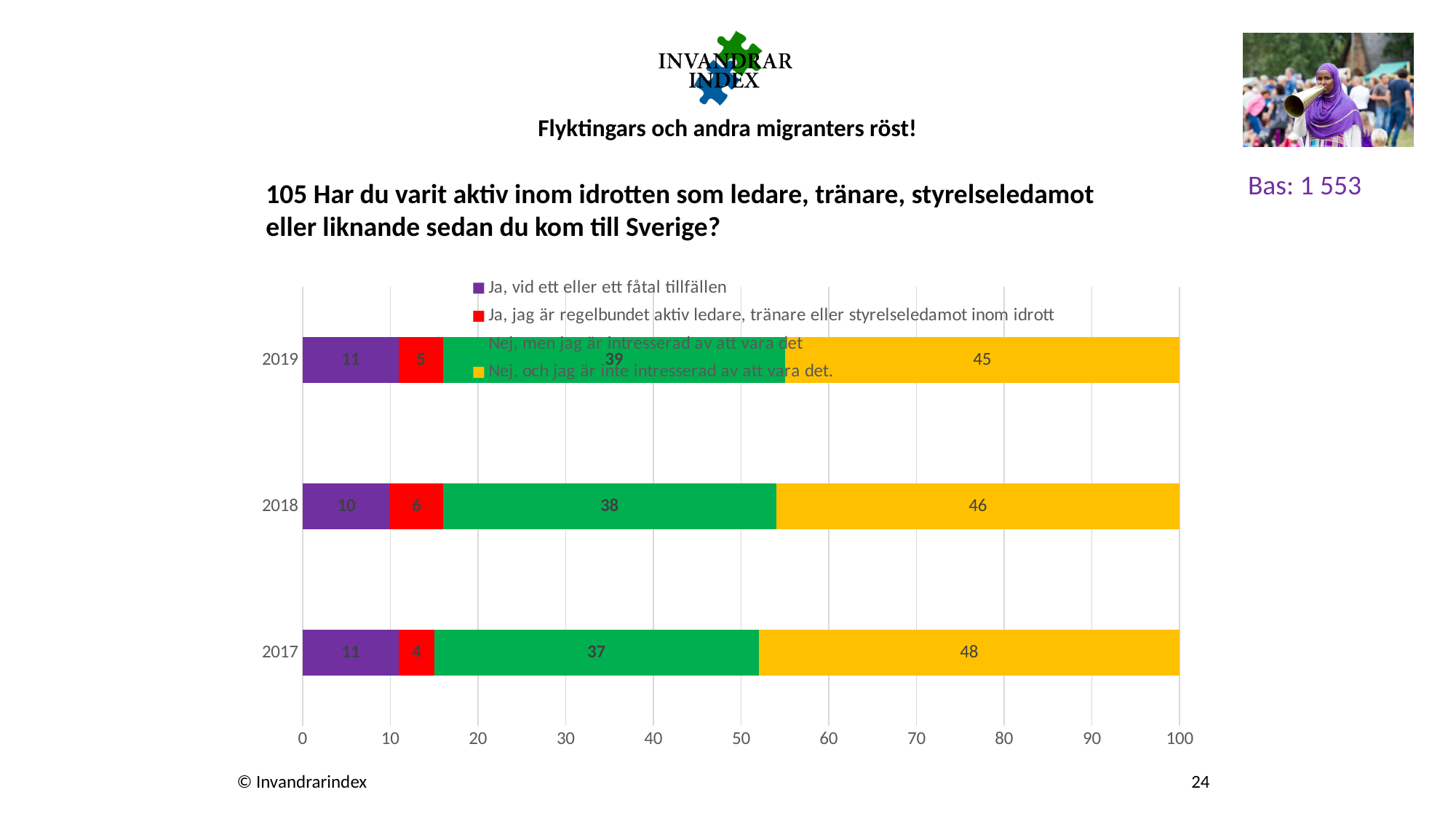
How many series does the legend list? 4 What is the total of the stacked bar for 2018? 100 What is the value for "Nej, men jag är intresserad av att vara det" in 2019? 39 How many years (categories) are shown on the chart? 3 What is the value for "Ja, jag är regelbundet aktiv ledare, tränare eller styrelseledamot inom idrott" in 2018? 6 What kind of chart is shown on the slide? Stacked bar chart Which is larger: the "Nej, men jag är intresserad av att vara det" value for 2019 or for 2017? 2019 What is the value for "Nej, och jag är inte intresserad av att vara det." in 2017? 48 In which year is the value for "Nej, och jag är inte intresserad av att vara det." highest? 2017 What is the difference between the "Nej, och jag är inte intresserad av att vara det." values for 2017 and 2019? 3 In which year is the value for "Ja, jag är regelbundet aktiv ledare, tränare eller styrelseledamot inom idrott" lowest? 2017 What is the value for "Ja, vid ett eller ett fåtal tillfällen" in 2018? 10